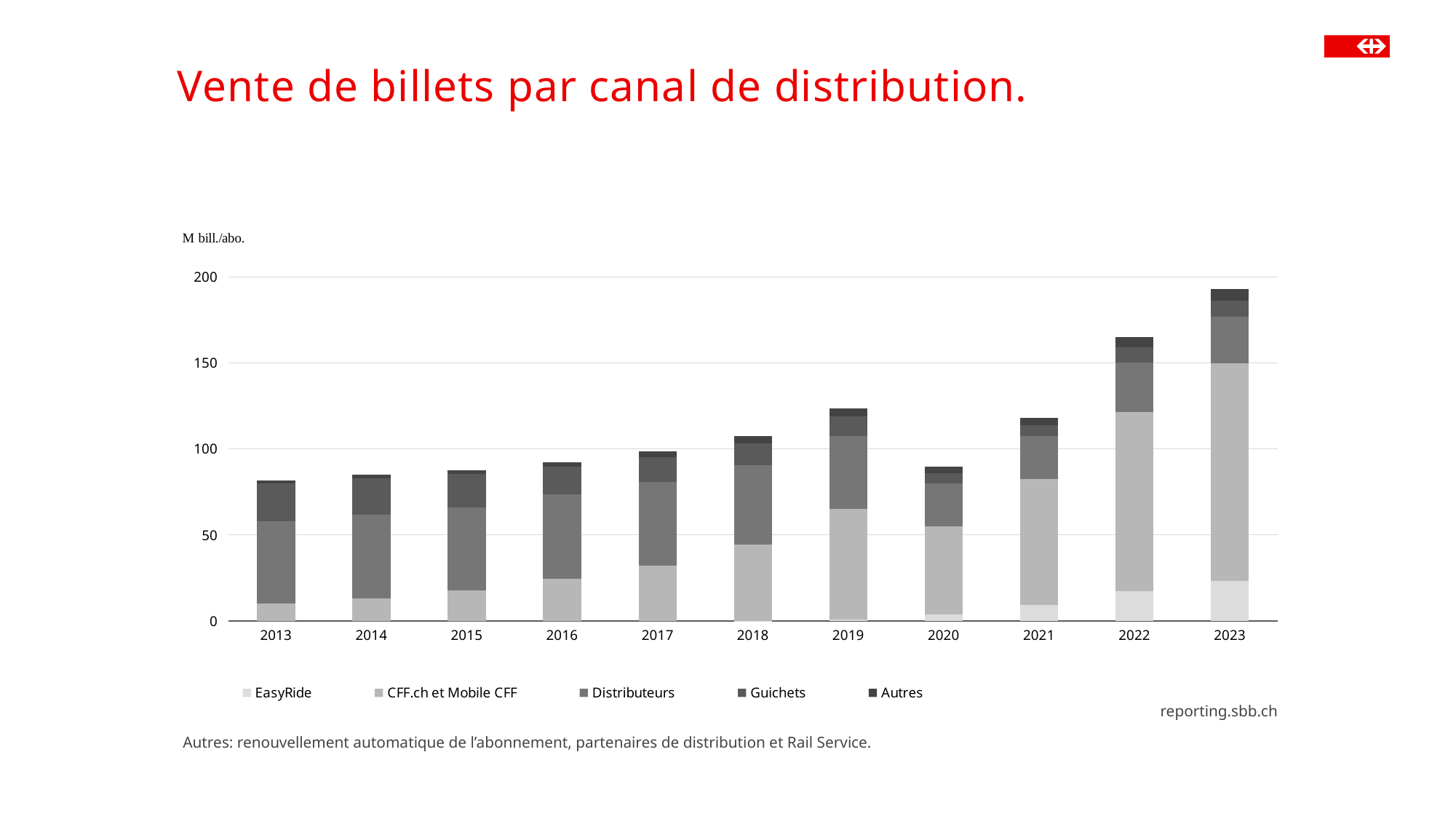
Which year has the lowest total bar? 2013 How many years are shown on the x axis of the chart? 11 Which year has the larger total bar, 2019 or 2020? 2019 Do the total bars rise or fall from 2013 to 2019? rise Is the total for 2013 greater or less than 100? less What is the title of the chart? Vente de billets par canal de distribution. What unit is shown above the y axis? M bill./abo. Is the total for 2023 greater or less than 150? greater Which year has the highest total bar? 2023 Is the total for 2020 greater or less than 100? less How many series does the legend list? 5 What kind of chart is shown on the slide? stacked bar chart